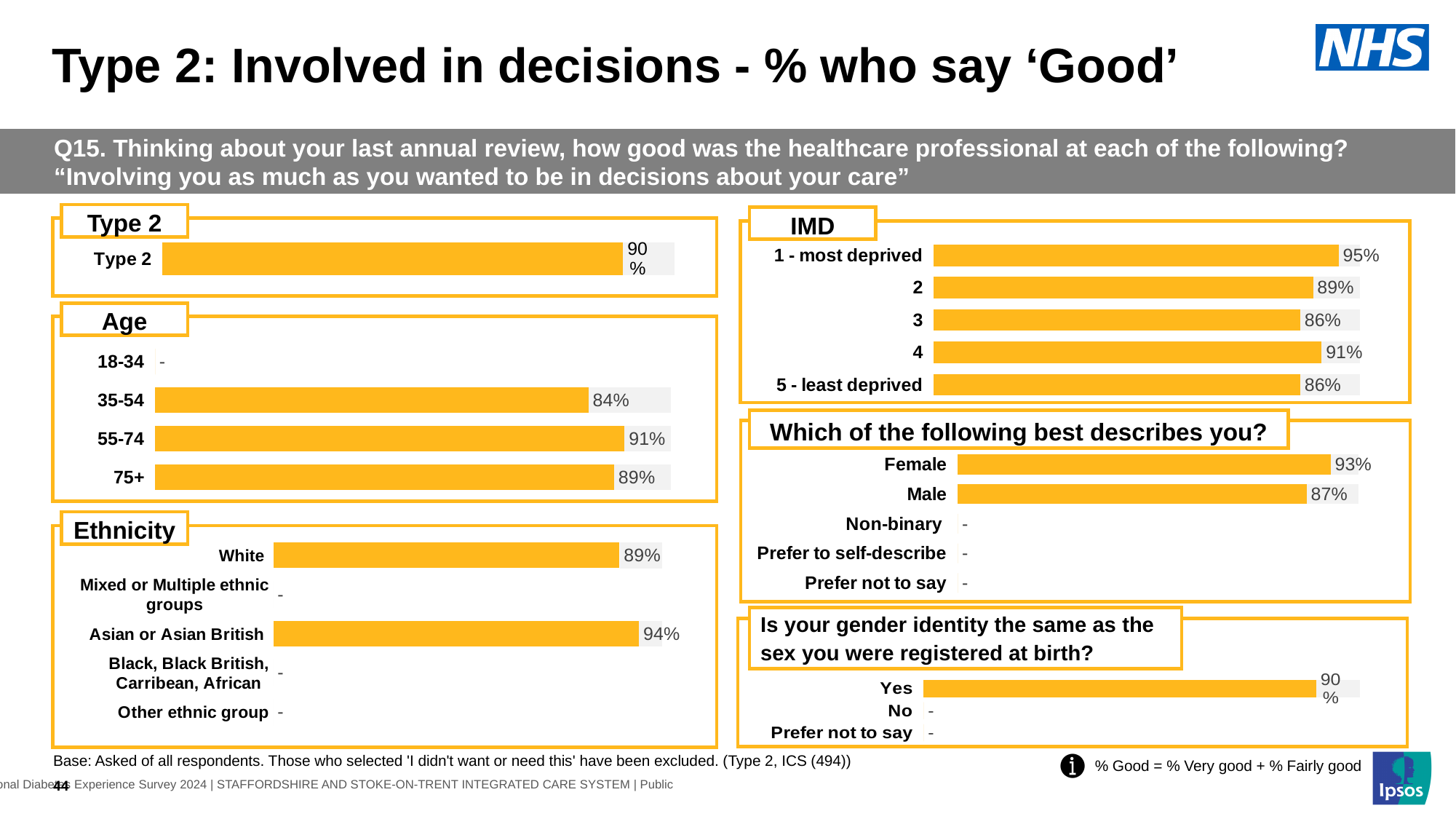
In the Age chart, what is the difference between the 55-74 and 35-54 values? 7 percentage points What type of chart is used in the IMD section? Bar chart In the IMD chart, what is the value for category 4? 91% In the 'Which of the following best describes you?' chart, what is the difference between the Female and Male values? 6 percentage points In the Ethnicity chart, which is larger, the value for White or for Asian or Asian British? Asian or Asian British In the Age chart, which age group with a plotted value has the highest percentage? 55-74 In the IMD chart, which category has the highest value? 1 - most deprived In the 'Is your gender identity the same as the sex you were registered at birth?' chart, what is the value for Yes? 90% In the Age chart, what is the value for the 35-54 age group? 84% In the IMD chart, how many categories are plotted? 5 In the Ethnicity chart, what is the value for Asian or Asian British? 94% In the Type 2 chart, what percentage of Type 2 respondents say 'Good'? 90%